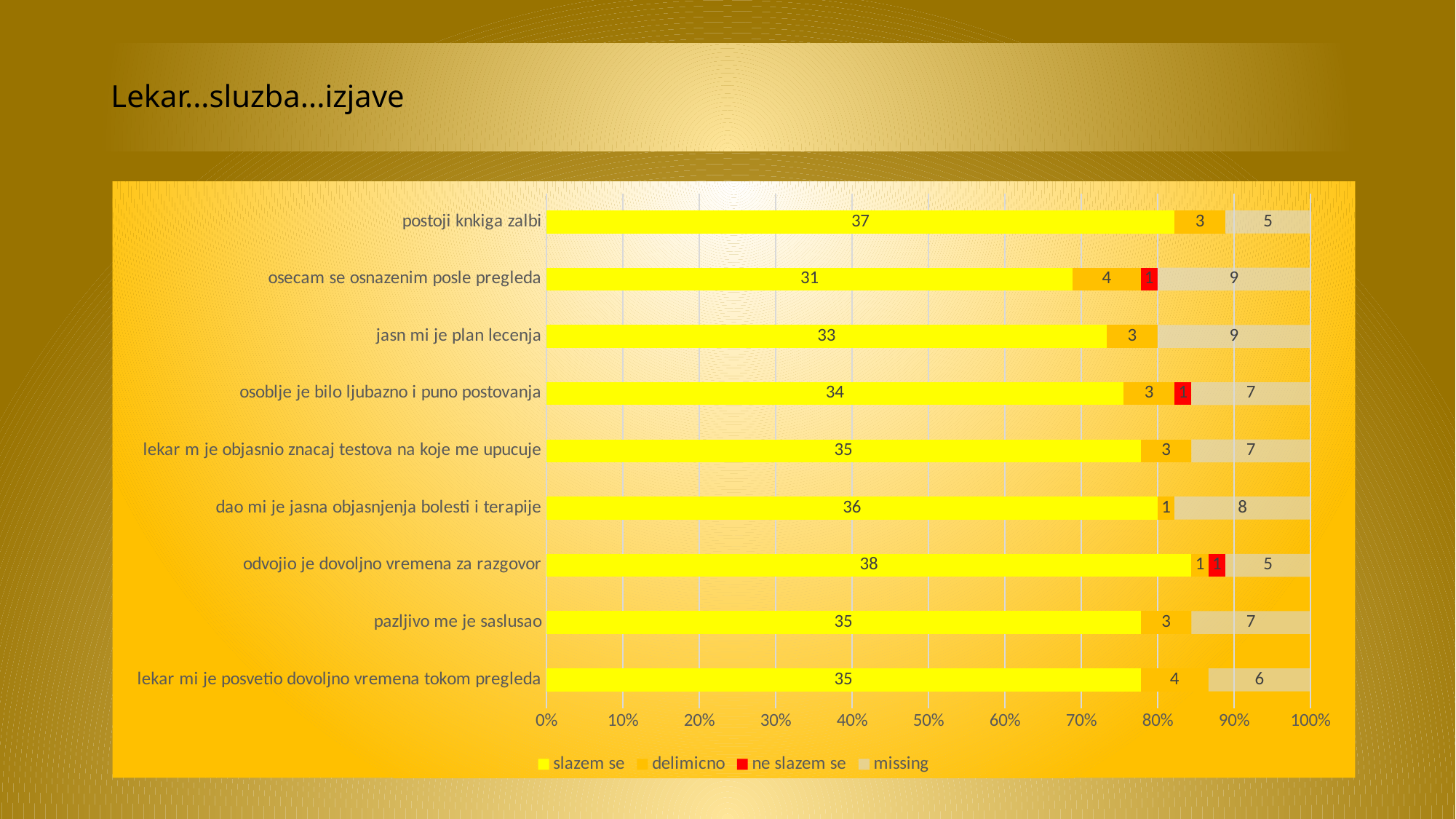
Which has a larger 'missing' value: 'jasn mi je plan lecenja' or 'postoji knkiga zalbi'? jasn mi je plan lecenja Which category has the highest 'slazem se' value? odvojio je dovoljno vremena za razgovor What kind of chart is shown on the slide? stacked bar chart Which category has the lowest 'slazem se' value? osecam se osnazenim posle pregleda How many series does the legend list? 4 What is the 'slazem se' value for 'postoji knkiga zalbi'? 37 Which series is shown in red in the legend? ne slazem se What is the total of all segments in the bar for 'osoblje je bilo ljubazno i puno postovanja'? 45 What is the 'missing' value for 'osecam se osnazenim posle pregleda'? 9 What is the difference between the 'slazem se' values for 'odvojio je dovoljno vremena za razgovor' and 'osecam se osnazenim posle pregleda'? 7 What is the 'delimicno' value for 'lekar mi je posvetio dovoljno vremena tokom pregleda'? 4 How many categories (statements) are plotted on the chart? 9